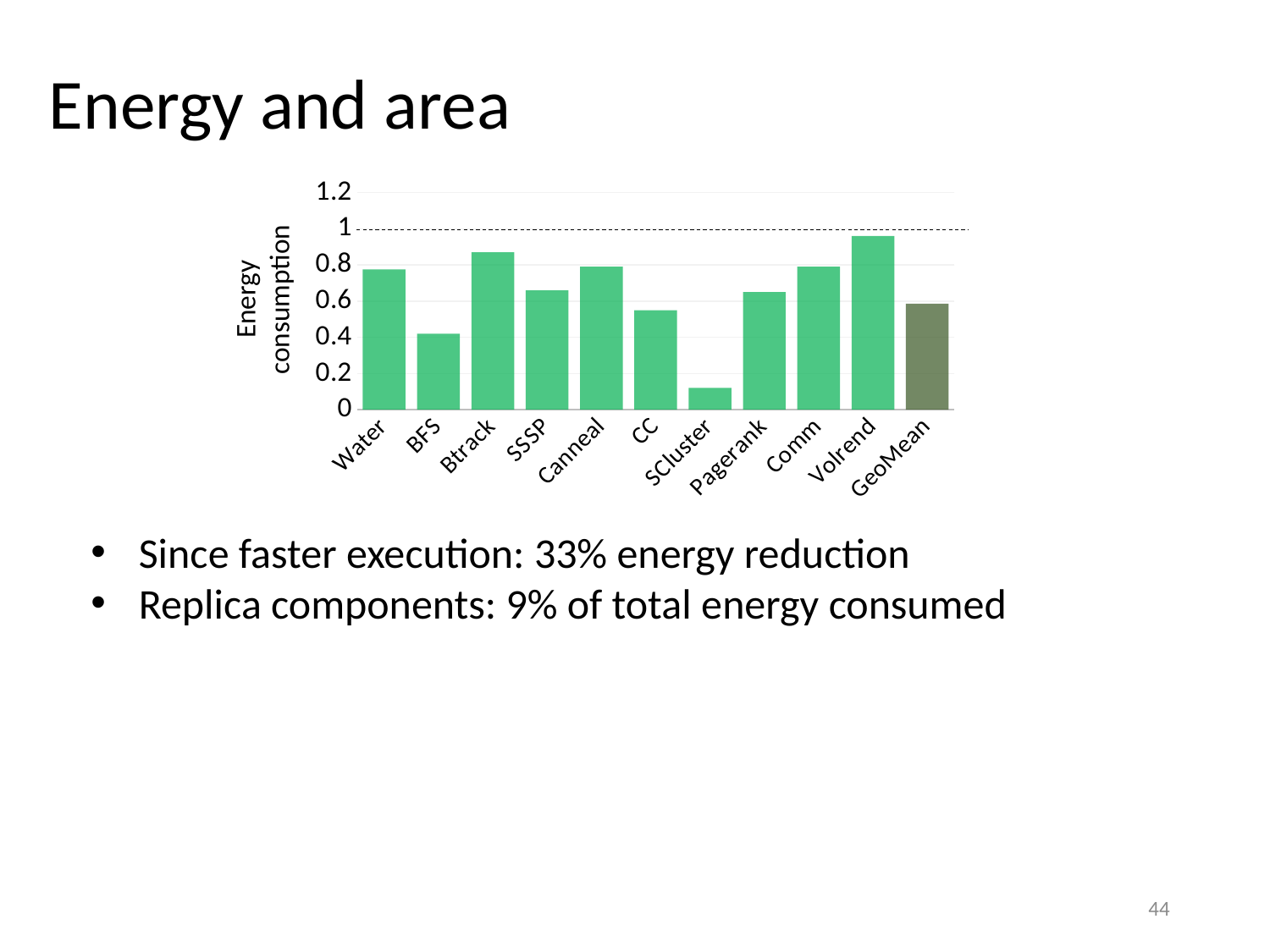
Which category has the lowest energy consumption in the chart? SCluster Is the value for GeoMean greater or less than 0.4? greater Which has the larger energy consumption, CC or Volrend? Volrend Which has the larger energy consumption, Btrack or BFS? Btrack Is the value for Btrack greater or less than 0.8? greater What kind of chart is shown on the slide? bar chart How many categories are plotted on the x axis of the chart? 11 Is the value for SCluster greater or less than 0.2? less What is the label on the y axis of the chart? Energy consumption Which category has the highest energy consumption in the chart? Volrend